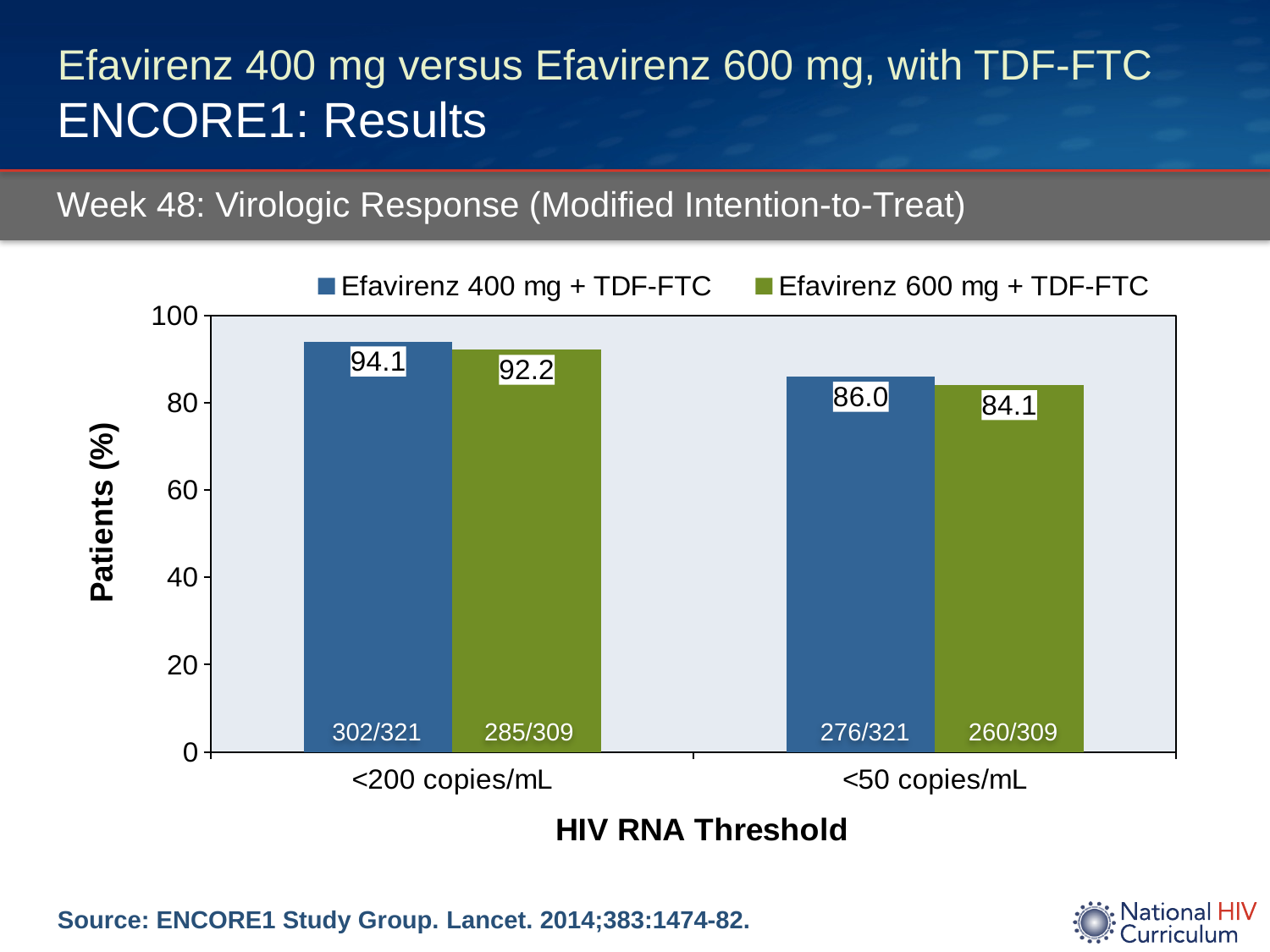
What kind of chart is shown on the slide? Bar chart Which bar has the highest value on the chart? Efavirenz 400 mg + TDF-FTC at <200 copies/mL What is the value for Efavirenz 400 mg + TDF-FTC at the <200 copies/mL threshold? 94.1 At the <200 copies/mL threshold, which series has the larger value? Efavirenz 400 mg + TDF-FTC What is the difference between the Efavirenz 400 mg + TDF-FTC and Efavirenz 600 mg + TDF-FTC values at the <50 copies/mL threshold? 1.9 Which bar has the lowest value on the chart? Efavirenz 600 mg + TDF-FTC at <50 copies/mL What fraction of patients is shown inside the Efavirenz 400 mg + TDF-FTC bar at the <50 copies/mL threshold? 276/321 How many series does the legend list? 2 What is the label of the y axis? Patients (%) How many HIV RNA threshold categories are shown on the x axis? 2 What is the value for Efavirenz 600 mg + TDF-FTC at the <50 copies/mL threshold? 84.1 What is the value for Efavirenz 600 mg + TDF-FTC at the <200 copies/mL threshold? 92.2